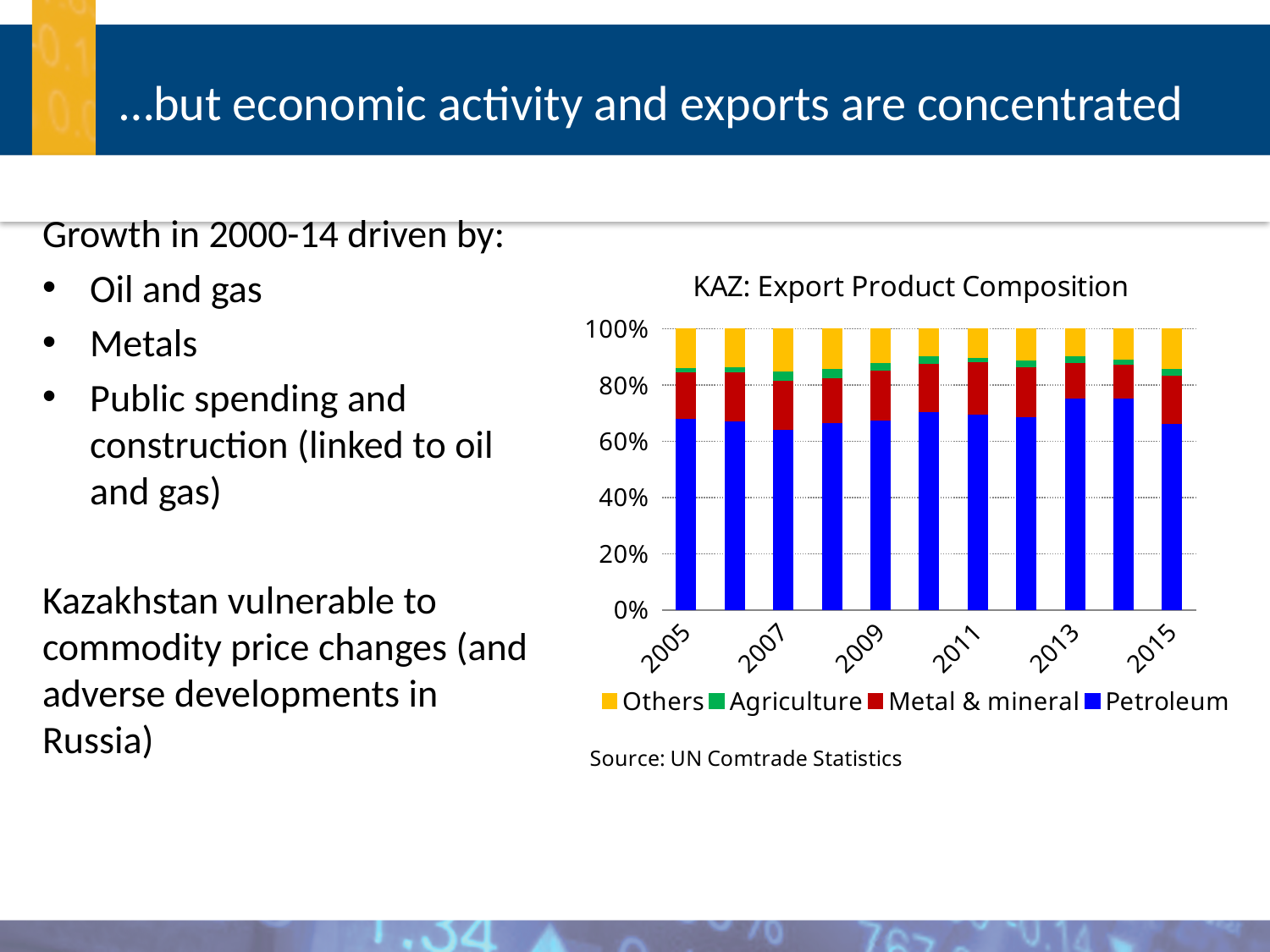
How many series does the chart's legend list? 4 Which year has the larger Petroleum share, 2007 or 2013? 2013 Which series makes up the largest share of exports in every year shown? Petroleum Is the Petroleum share in 2005 greater or less than 60%? greater Is the Petroleum share in 2015 greater or less than 60%? greater What does each stacked bar total? 100% What source is cited below the chart? UN Comtrade Statistics What is the title of the chart? KAZ: Export Product Composition Is the Petroleum share in 2013 greater or less than 80%? less How many years (bars) are plotted in the chart? 11 Which series makes up the smallest share of exports in the chart? Agriculture What kind of chart is shown on the slide? Stacked bar chart